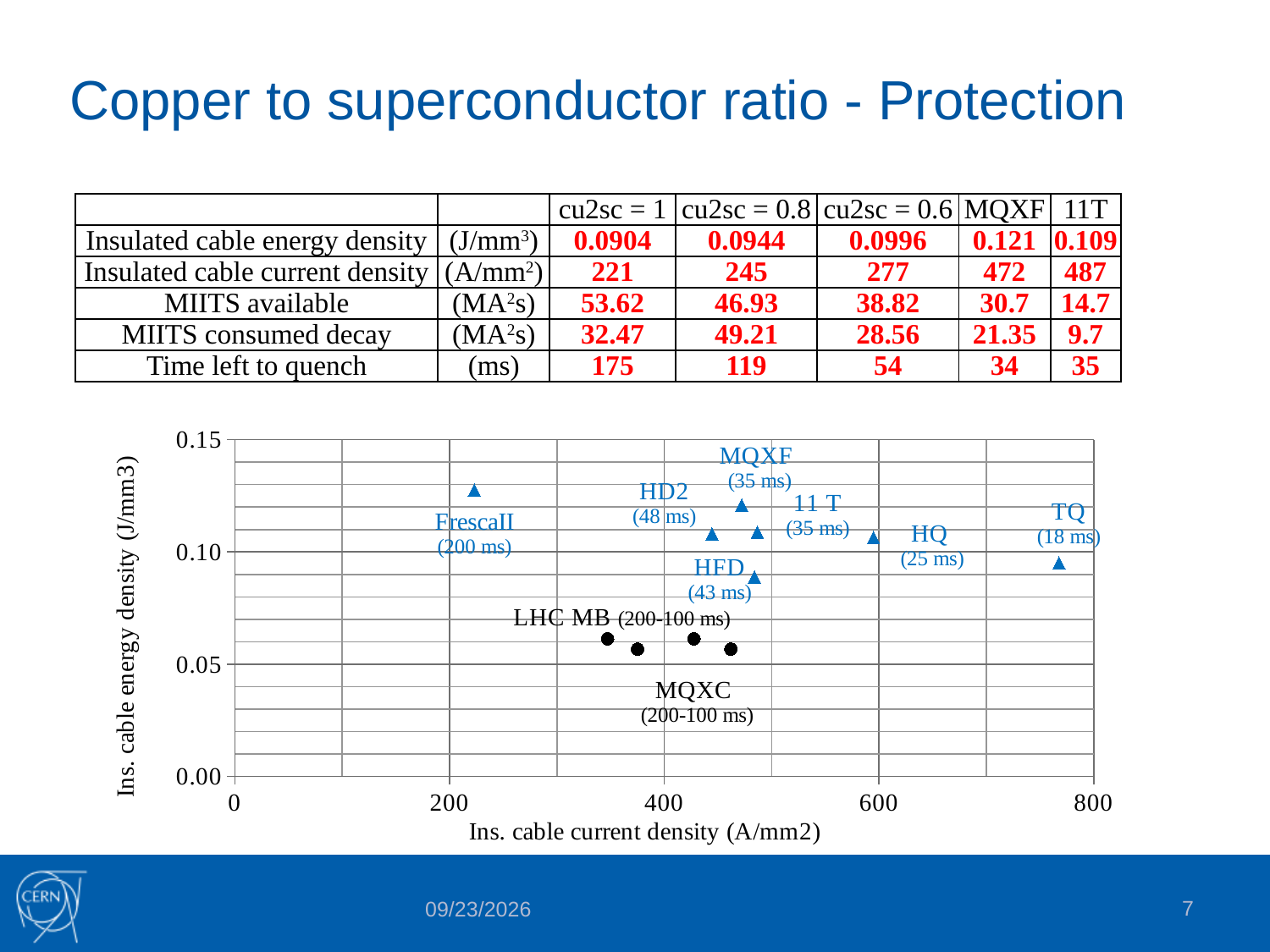
What kind of chart is shown on the slide? scatter chart Is the current density of the TQ point greater or less than 600 A/mm2? greater What time is annotated next to the HFD point in the chart? 43 ms Is the energy density of the FrescaII point greater or less than 0.10 J/mm3? greater Which labeled magnet has the highest current density in the chart? TQ Is the energy density of the LHC MB points greater or less than 0.10 J/mm3? less What is the label of the x axis of the chart? Ins. cable current density (A/mm2) What time is annotated next to the TQ point in the chart? 18 ms What is the label of the y axis of the chart? Ins. cable energy density (J/mm3) Which labeled magnet has the lowest current density in the chart? FrescaII Which has the higher energy density in the chart, FrescaII or HFD? FrescaII